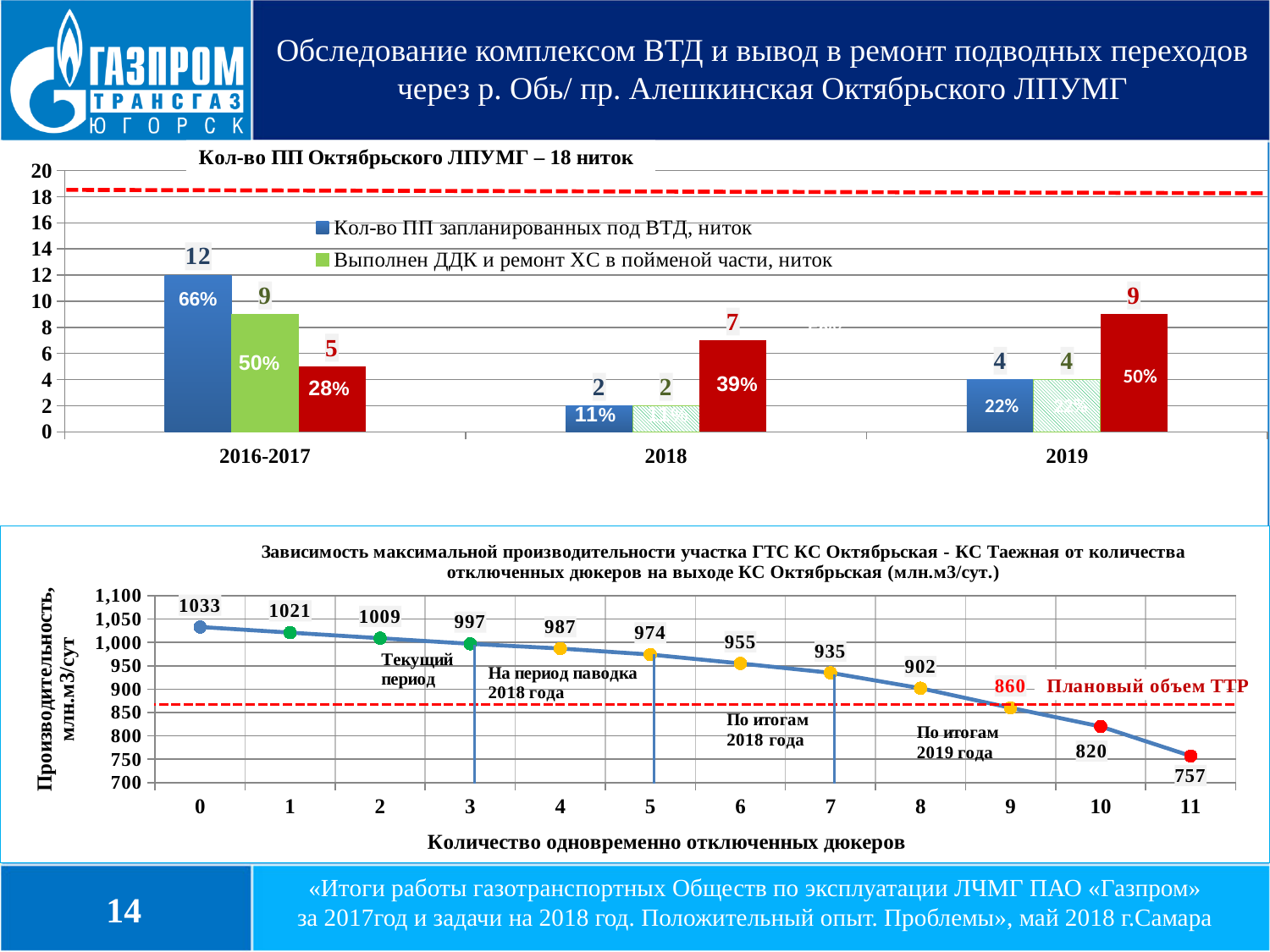
In the top bar chart, how many year groups are shown on the x axis? 3 In the top bar chart, what is the difference between the blue bar (12) and the green bar (9) for 2016-2017? 3 In the bottom line chart, what is the productivity value when 0 дюкеров are switched off? 1033 In the bottom line chart, what is the productivity value when 11 дюкеров are switched off? 757 In the bottom line chart, what is the difference between the values at 0 дюкеров (1033) and 9 дюкеров (860)? 173 What type of chart is the bottom chart on the slide? line chart In the top bar chart, what is the value of 'Кол-во ПП запланированных под ВТД, ниток' for 2016-2017? 12 In the bottom line chart, do the values rise or fall as the number of switched-off дюкеров increases? fall In the top bar chart, what is the value of 'Выполнен ДДК и ремонт ХС в пойменой части, ниток' for 2019? 4 In the top bar chart, how many series does the legend list? 2 In the top bar chart, what percentage label is shown on the blue bar for 2018? 11% In the top bar chart, which year group has the highest value for 'Кол-во ПП запланированных под ВТД, ниток'? 2016-2017